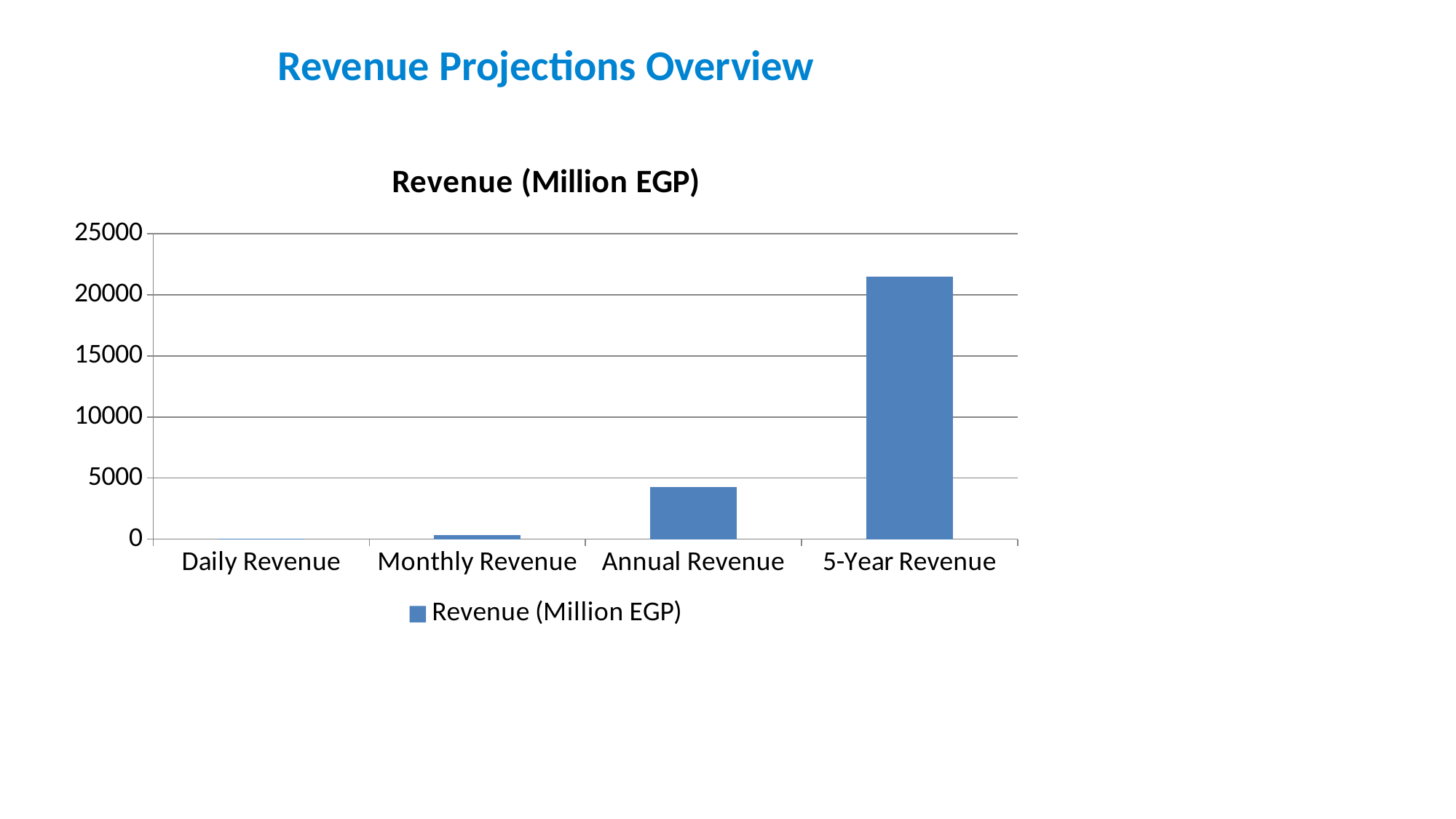
How many series does the legend list? 1 What is the name of the series listed in the legend? Revenue (Million EGP) Which category has the lowest value? Daily Revenue How many categories are shown on the x axis of the chart? 4 Is the value for Monthly Revenue greater or less than 5000? less Which is larger, the value for Annual Revenue or the value for Monthly Revenue? Annual Revenue Is the value for 5-Year Revenue greater or less than 20000? greater What is the title of the chart? Revenue (Million EGP) What kind of chart is shown on the slide? bar chart Is the value for Annual Revenue greater or less than 5000? less Which category has the highest value? 5-Year Revenue Do the values rise or fall from left to right along the x axis? rise